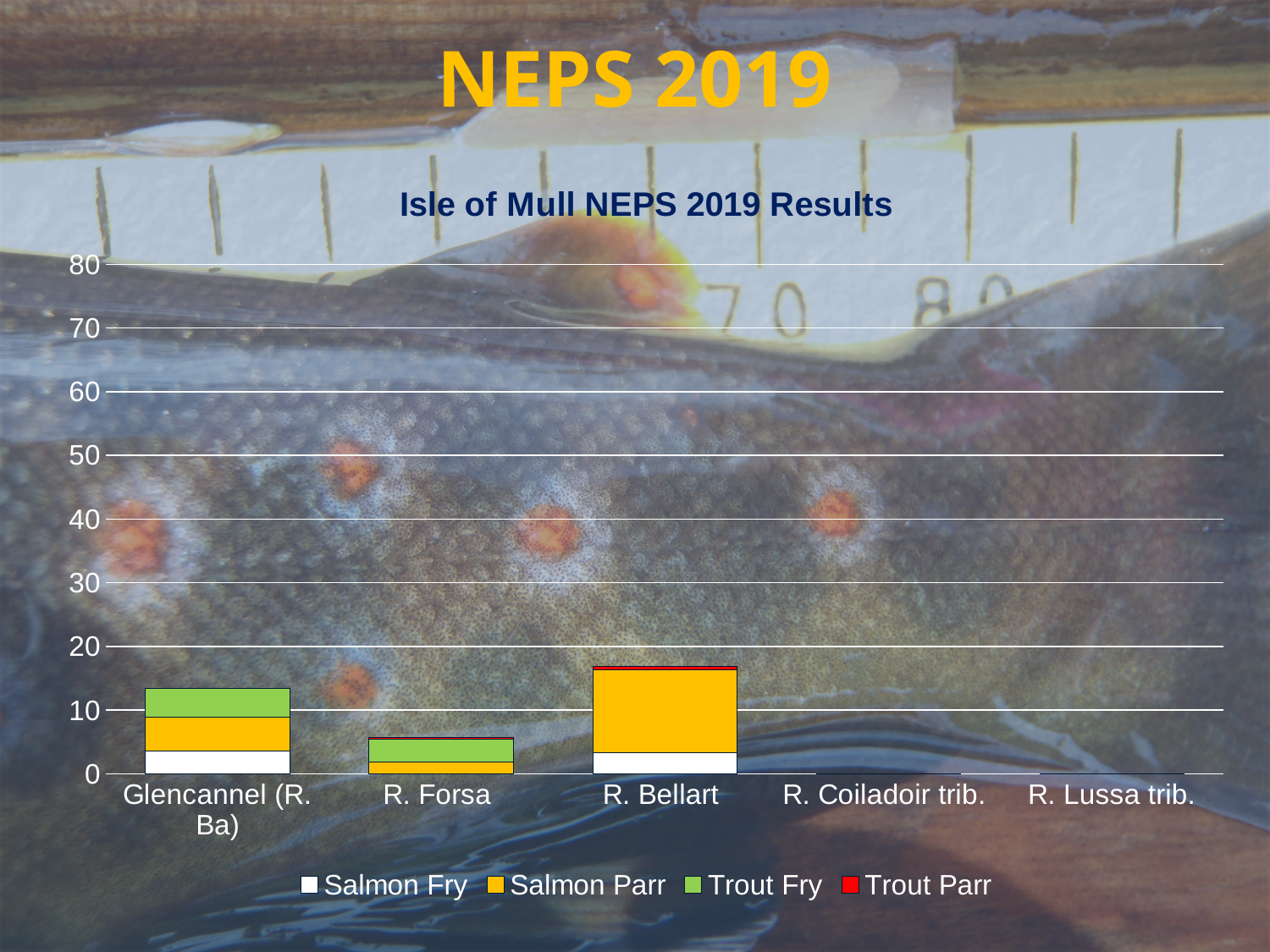
What is the highest value shown on the y axis? 80 Which has the larger total stacked bar, Glencannel (R. Ba) or R. Forsa? Glencannel (R. Ba) How many series does the legend list? 4 How many river sites (categories) are shown on the x axis? 5 Which series makes up most of the R. Bellart bar? Salmon Parr What kind of chart is shown on the slide? Stacked bar chart Is the total stacked value for R. Bellart greater or less than 20? less What is the title of the chart? Isle of Mull NEPS 2019 Results Is the total stacked value for Glencannel (R. Ba) greater or less than 10? greater Is the total stacked value for R. Forsa greater or less than 10? less Which site has the tallest stacked bar? R. Bellart